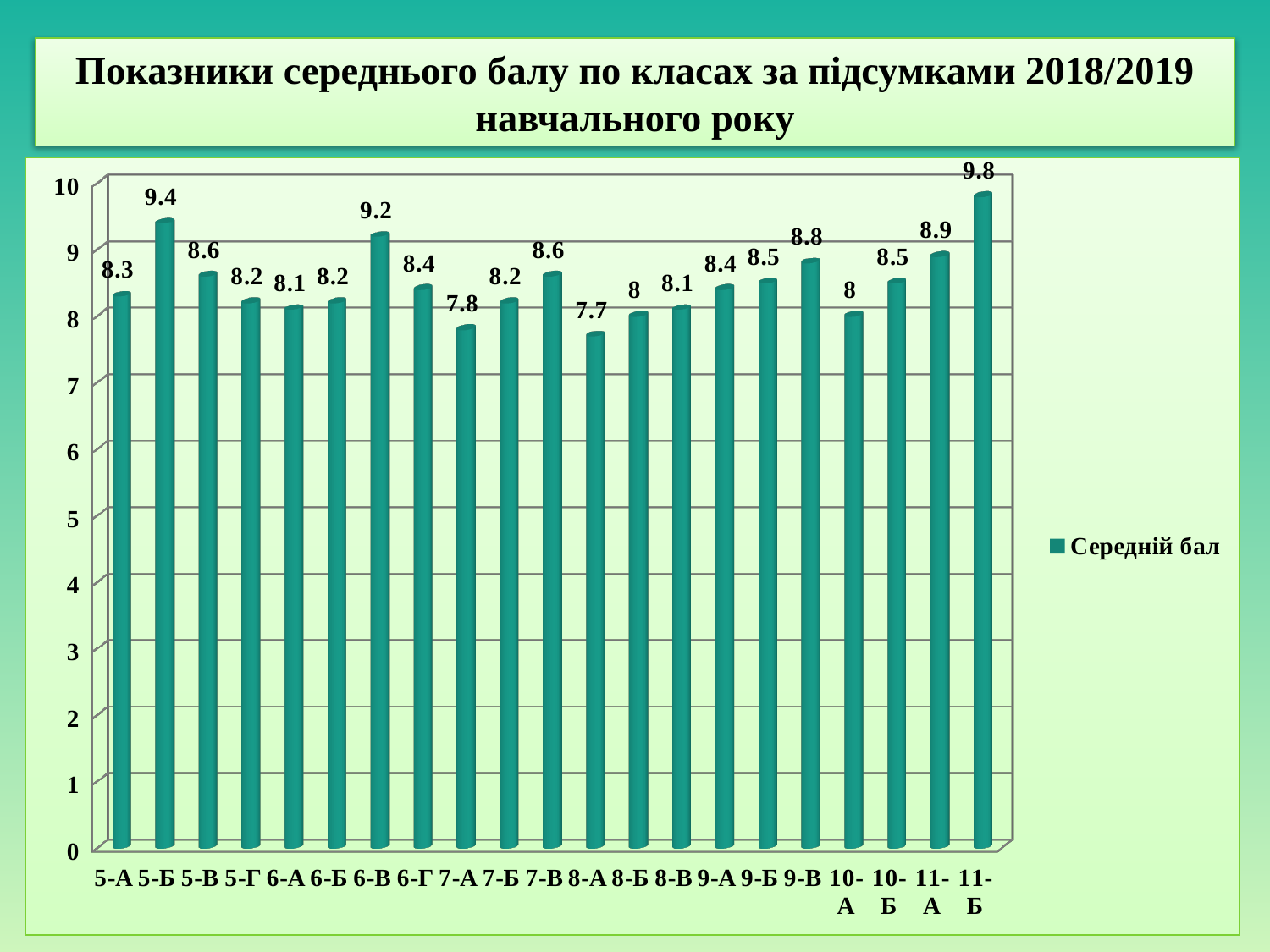
Is the value for 7-А greater or less than 8? less What is the value for 10-А? 8 Which class has the lowest average score? 8-А How many series does the legend list? 1 What is the value for 8-А? 7.7 Which class has the highest average score? 11-Б What kind of chart is shown on the slide? bar chart What is the value for 5-Б? 9.4 Which is larger, the value for 6-В or the value for 11-А? 6-В How many classes are shown on the x axis? 21 What is the difference between the values for 11-Б and 8-А? 2.1 What is the value for 9-В? 8.8